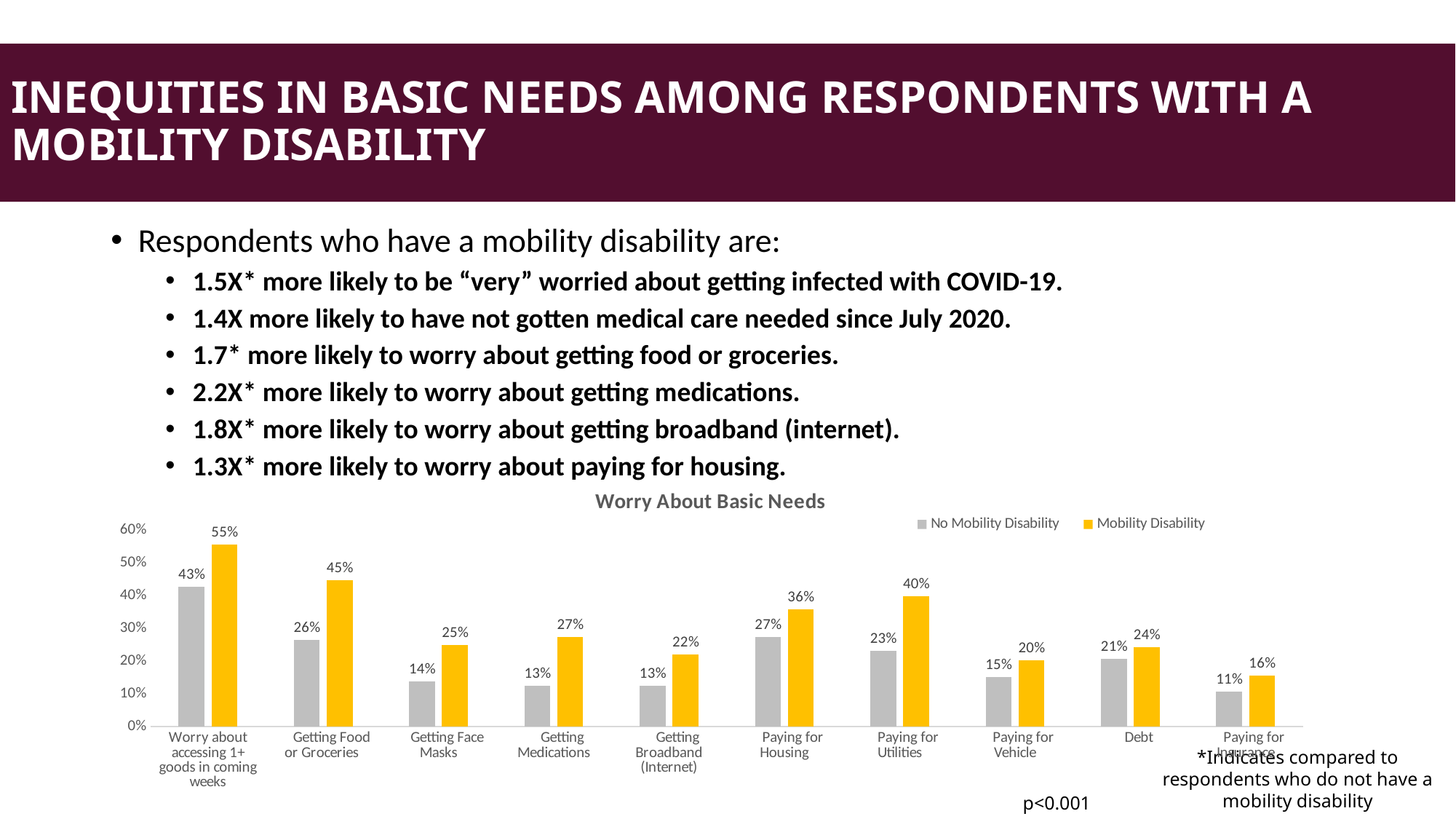
Which category has the lowest No Mobility Disability value? Paying for Insurance What is the Mobility Disability value for Getting Food or Groceries? 45% What kind of chart is shown on the slide? Bar chart What is the title of the chart? Worry About Basic Needs How many series does the chart legend list? 2 What is the No Mobility Disability value for Paying for Utilities? 23% Which colour represents the Mobility Disability series in the chart? Yellow Is the Mobility Disability value for Getting Broadband (Internet) greater or less than 30%? less Which is larger: the Mobility Disability value for Paying for Housing or the Mobility Disability value for Paying for Utilities? Paying for Utilities What is the difference between the Mobility Disability and No Mobility Disability values for Getting Medications? 14% Which category has the highest Mobility Disability value? Worry about accessing 1+ goods in coming weeks How many categories are shown on the x axis of the chart? 10